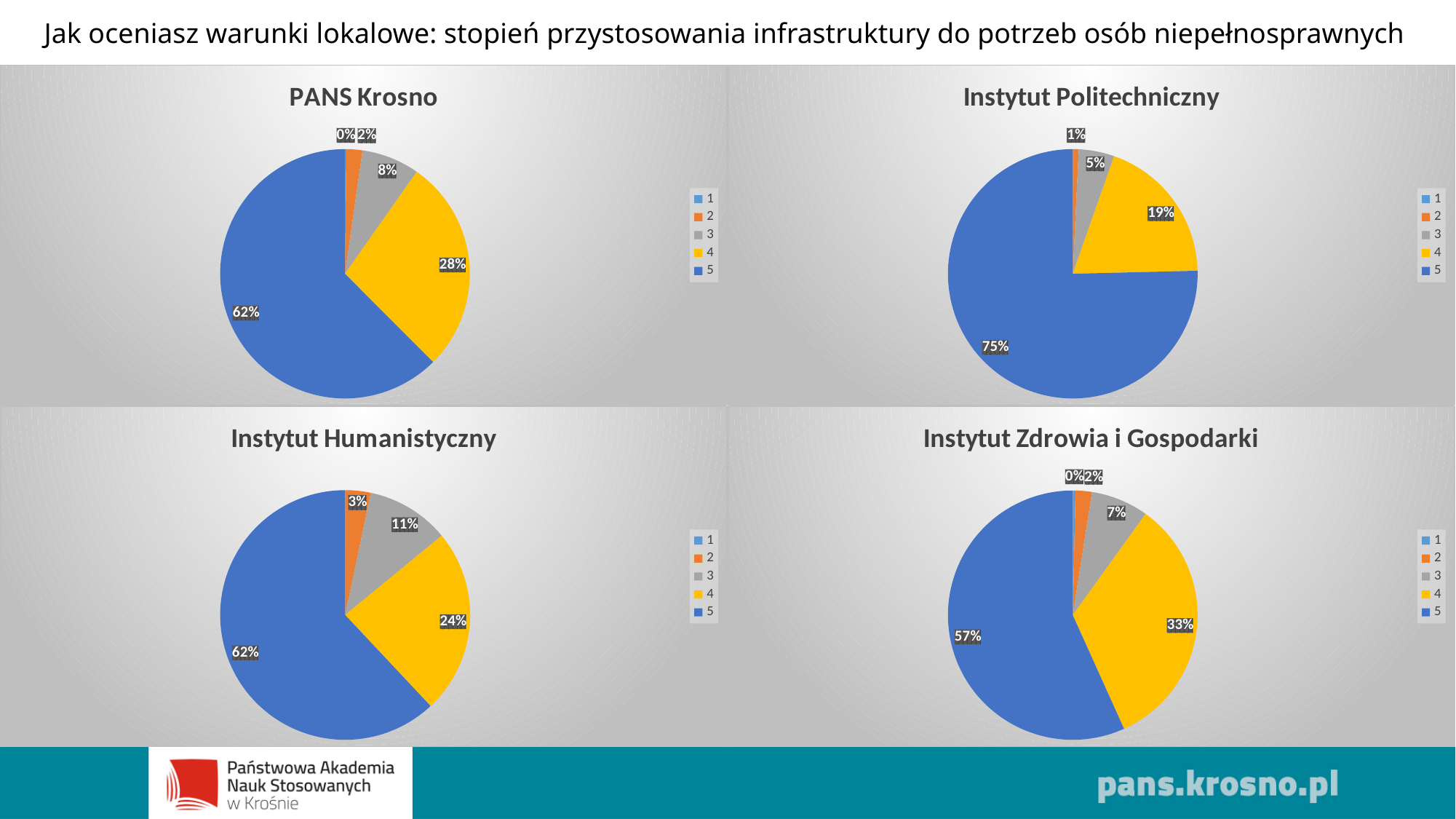
In the PANS Krosno chart, what share does category 4 have? 28% What kind of chart is the Instytut Humanistyczny chart? pie chart In the Instytut Politechniczny chart, what share does category 5 have? 75% In the PANS Krosno chart, what share does category 5 have? 62% In the Instytut Politechniczny chart, what share does category 4 have? 19% In the PANS Krosno chart, which is larger: the share of category 3 or category 4? category 4 In the Instytut Humanistyczny chart, what share does category 3 have? 11% In the Instytut Zdrowia i Gospodarki chart, what share does category 4 have? 33% How many charts are shown on the slide? 4 In the Instytut Humanistyczny chart, what is the difference between the shares of category 5 and category 4? 38% In the Instytut Zdrowia i Gospodarki chart, which category has the largest slice? 5 How many series does the legend of the Instytut Politechniczny chart list? 5